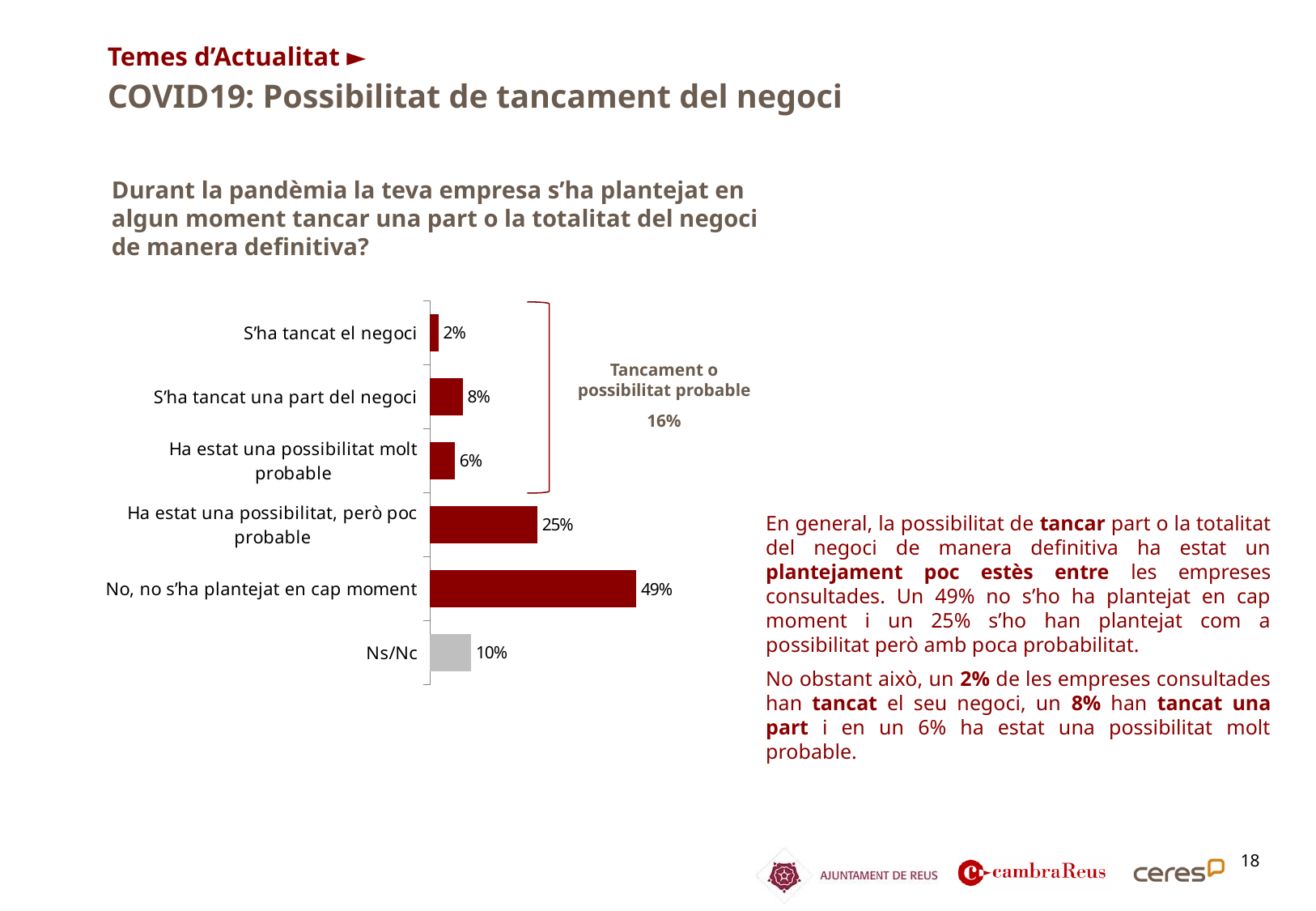
What is the difference between "No, no s'ha plantejat en cap moment" and "Ha estat una possibilitat, però poc probable"? 24% Which category has the highest value? No, no s'ha plantejat en cap moment How many categories are shown in the chart? 6 What kind of chart is shown on the slide? Bar chart What is the value for "Ns/Nc"? 10% What is the value for "S'ha tancat una part del negoci"? 8% Which category has the lowest value? S'ha tancat el negoci What is the value for "No, no s'ha plantejat en cap moment"? 49% Which is larger, "S'ha tancat una part del negoci" or "Ha estat una possibilitat molt probable"? S'ha tancat una part del negoci Which bar is shown in grey rather than dark red? Ns/Nc What is the combined total of the three categories grouped under "Tancament o possibilitat probable"? 16% What is the value for "Ha estat una possibilitat molt probable"? 6%